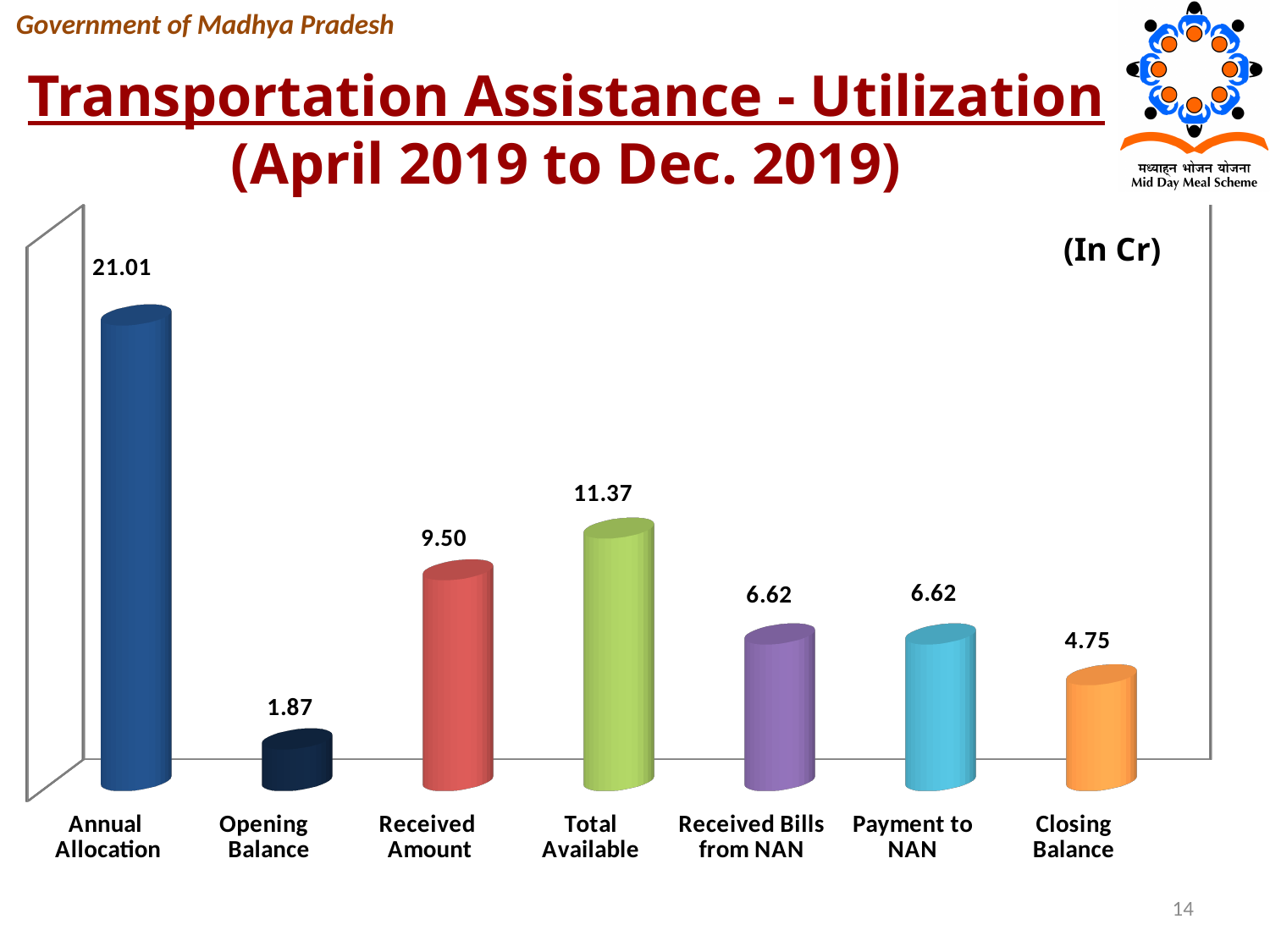
Which is larger, Received Amount or Received Bills from NAN? Received Amount What unit is indicated for the values in the chart? In Cr Which category has the lowest value? Opening Balance What is the value for Closing Balance? 4.75 What is the difference between Annual Allocation and Total Available? 9.64 What is the value for Total Available? 11.37 How many categories are shown in the chart? 7 What kind of chart is shown on the slide? Bar chart What is the value for Annual Allocation? 21.01 What is the value for Opening Balance? 1.87 What is the difference between Received Amount and Closing Balance? 4.75 Which category has the highest value? Annual Allocation